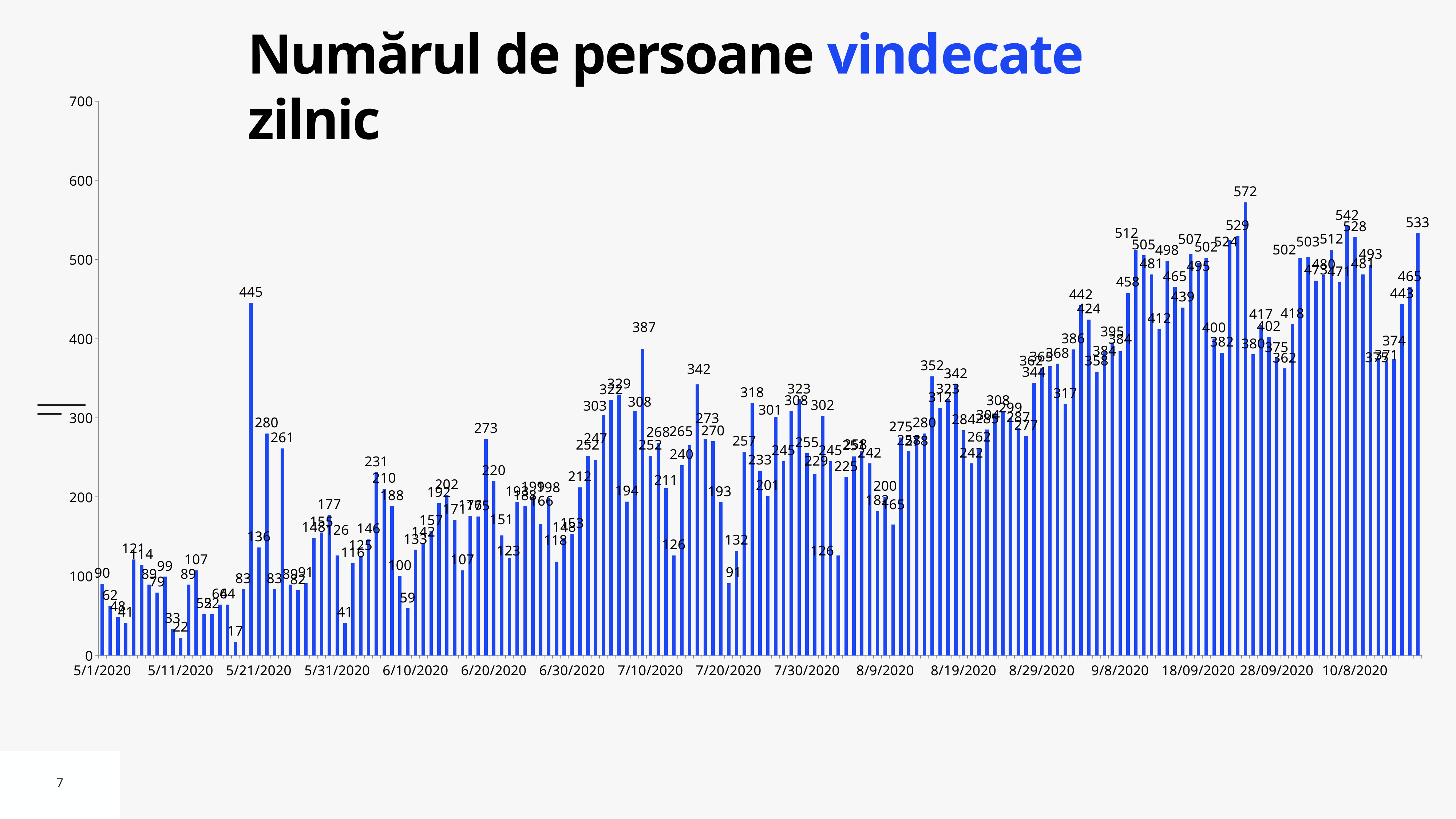
Is the value for 5/1/2020 greater or less than 100? less Which is larger, the value of the first bar (5/1/2020) or the value of the last bar? the last bar What is the title of the chart? Numărul de persoane vindecate zilnic What is the maximum value shown on the vertical axis? 700 What kind of chart is shown on the slide? bar chart What is the value for 5/1/2020, the first bar in the chart? 90 Overall, do the daily values rise or fall from May 2020 to October 2020? rise What is the difference between the highest value (572) and the lowest value (17) in the chart? 555 What is the highest daily value shown in the chart? 572 What is the lowest daily value shown in the chart? 17 What is the difference between the last bar (533) and the first bar (90)? 443 What is the value of the last bar in the chart? 533